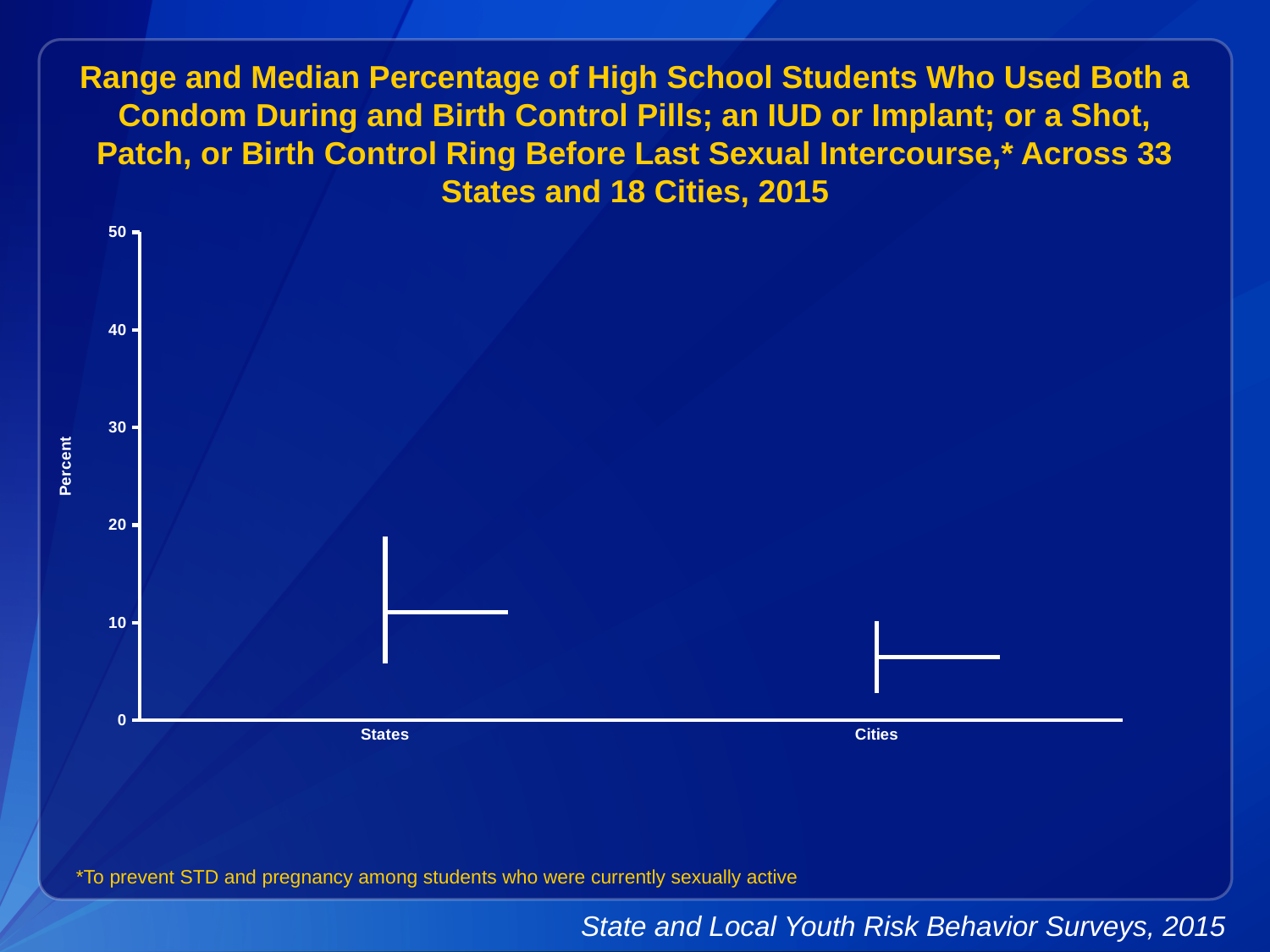
Is the median value for Cities greater or less than 10? less Is the bottom of the range for States greater or less than 10? less Which category has the lower median percentage? Cities Is the top of the range for Cities greater or less than 20? less What are the two categories shown on the x axis? States and Cities What is the highest value shown on the y axis? 50 What is the label of the y axis? Percent How many categories are shown on the x axis of the chart? 2 Which category has the higher median percentage, States or Cities? States Which category has the higher top of its range, States or Cities? States